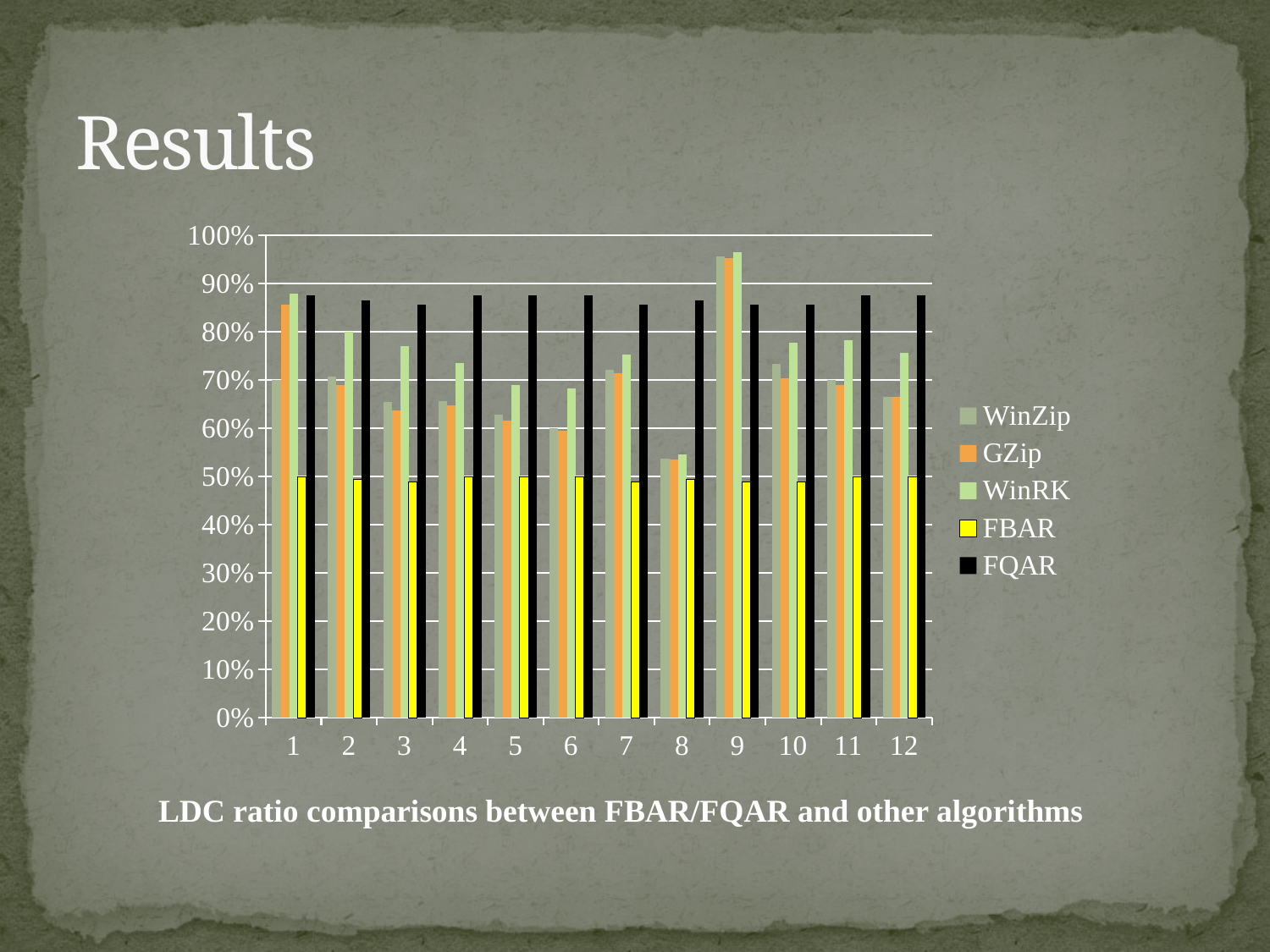
Is the GZip value for category 3 greater or less than 70%? less What kind of chart is shown on the slide? bar chart Is the FQAR value for category 1 greater or less than 80%? greater How many series does the legend list? 5 Which category has the highest WinRK value? 9 Is the WinZip value for category 8 greater or less than 60%? less For category 9, which is larger, the WinRK value or the FQAR value? WinRK How many categories are shown along the x axis? 12 Which category has the lowest WinZip value? 8 Which series is drawn in yellow? FBAR For category 8, which is larger, the FQAR value or the WinZip value? FQAR